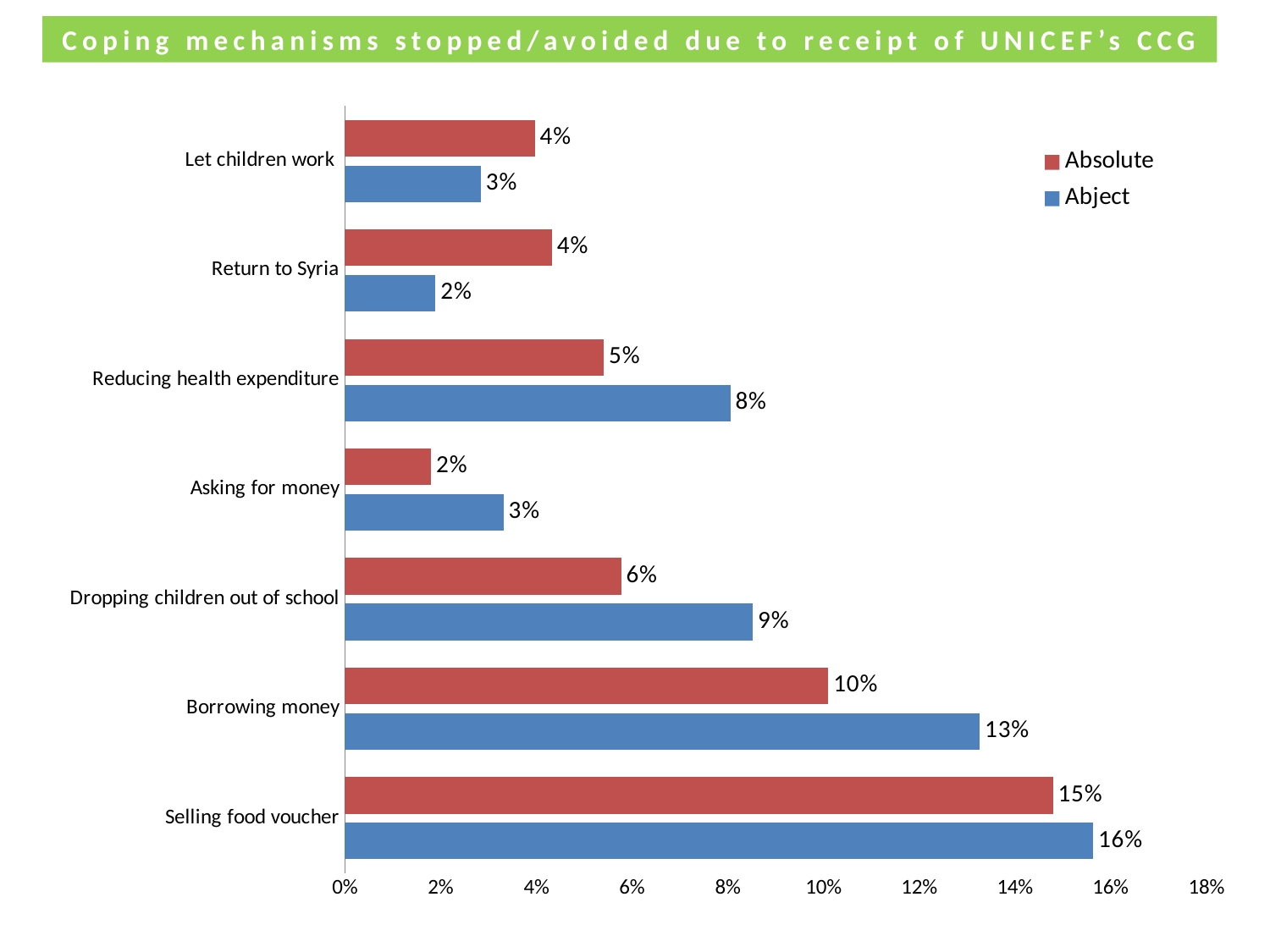
Which category has the highest Abject value? Selling food voucher What is the Abject value for Borrowing money? 13% Is the Absolute value for Selling food voucher greater or less than 14%? greater How many series does the legend list? 2 What kind of chart is shown on the slide? Bar chart Which category has the lowest Absolute value? Asking for money How many coping mechanism categories are shown on the chart? 7 What is the difference between the Abject and Absolute values for Dropping children out of school? 3% Which colour represents the Abject series? Blue What is the Absolute value for Reducing health expenditure? 5% Which is larger for Reducing health expenditure, the Absolute value or the Abject value? Abject What is the Abject value for Return to Syria? 2%